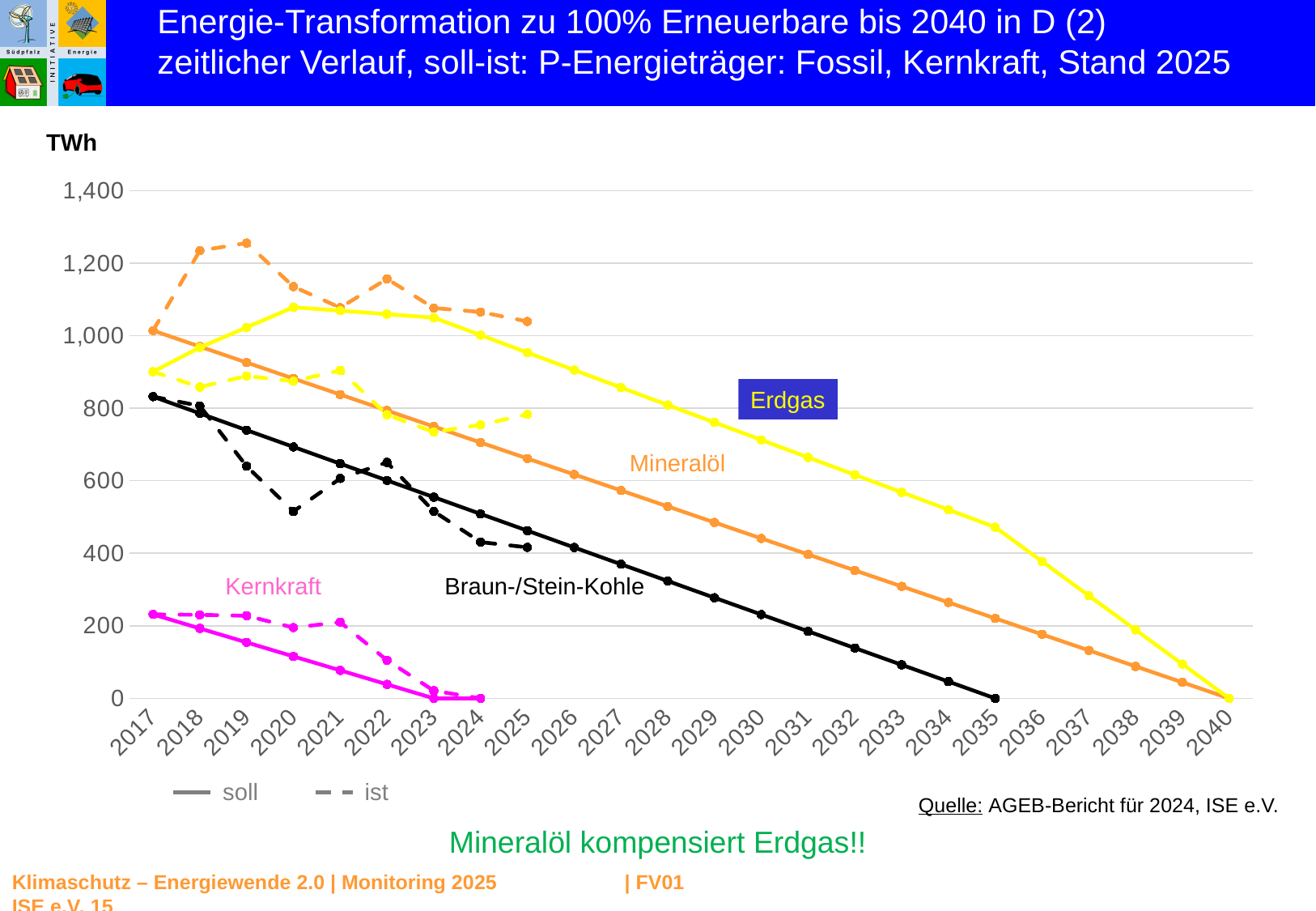
Which energy carrier is drawn in magenta in the chart? Kernkraft What unit is given for the y axis of the chart? TWh In 2017, which soll value is higher, Mineralöl or Erdgas? Mineralöl Does the Erdgas soll line rise or fall from 2021 to 2040? fall In which year does the Braun-/Stein-Kohle soll line reach 0? 2035 Is the Braun-/Stein-Kohle ist value for 2020 greater or less than 600? less What kind of chart is shown on the slide? line chart How many years are shown on the x axis of the chart? 24 Is the Mineralöl ist value for 2019 greater or less than 1,200? greater What value does the Erdgas soll line reach in 2040? 0 How many entries does the legend below the chart list? 2 Which energy carrier has the highest soll value in 2030? Erdgas